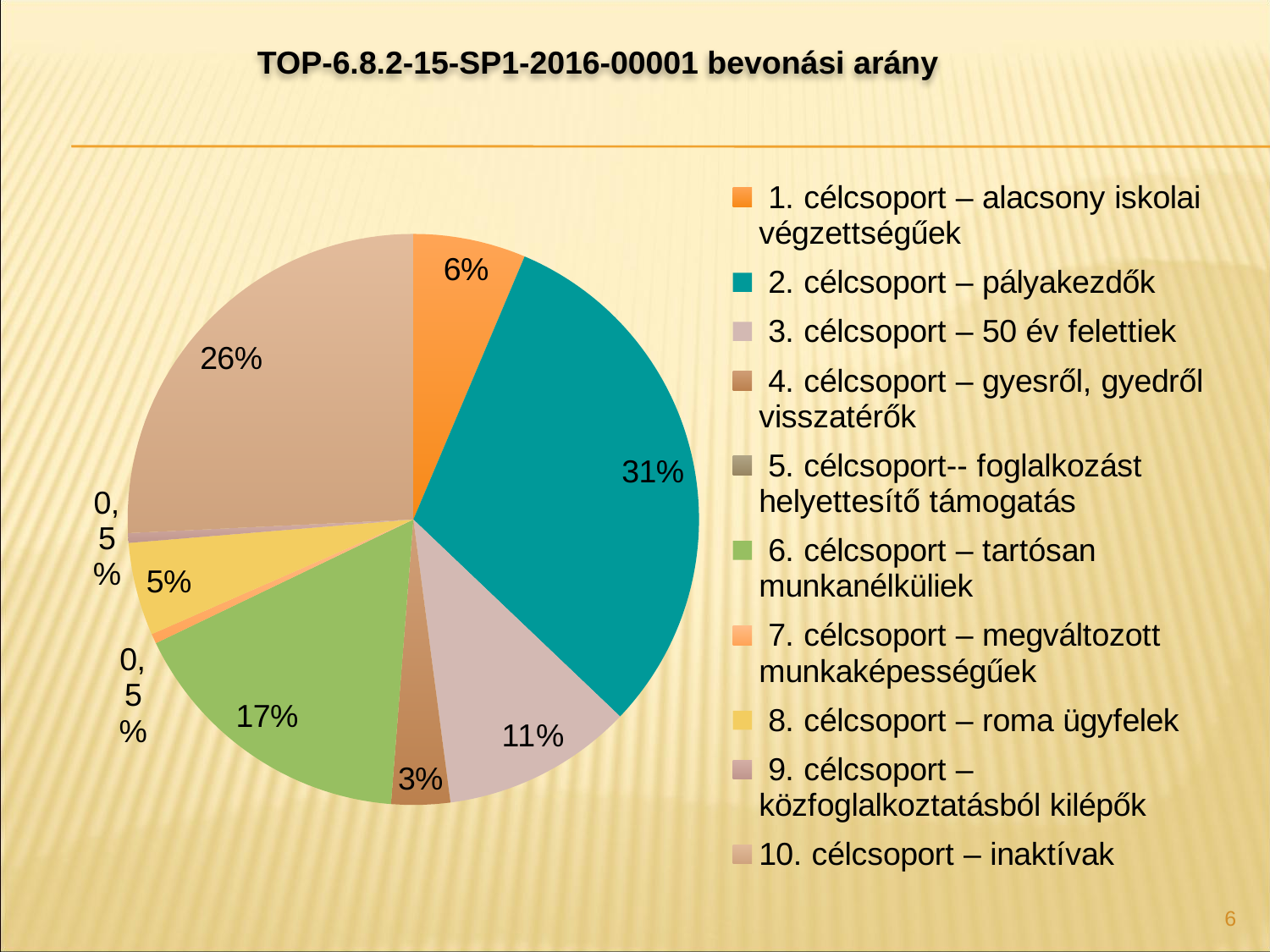
What share of the pie does '8. célcsoport – roma ügyfelek' have? 5% Which category has the largest share of the pie? 2. célcsoport – pályakezdők What share of the pie does '10. célcsoport – inaktívak' have? 26% What is the difference between the share for '2. célcsoport – pályakezdők' and the share for '3. célcsoport – 50 év felettiek'? 20% What share of the pie does '6. célcsoport – tartósan munkanélküliek' have? 17% How many categories does the legend list? 10 What share of the pie does '2. célcsoport – pályakezdők' have? 31% What share of the pie does '4. célcsoport – gyesről, gyedről visszatérők' have? 3% What share of the pie does '3. célcsoport – 50 év felettiek' have? 11% What kind of chart is shown on the slide? pie chart Which is larger, the share for '10. célcsoport – inaktívak' or the share for '6. célcsoport – tartósan munkanélküliek'? 10. célcsoport – inaktívak What share of the pie does '1. célcsoport – alacsony iskolai végzettségűek' have? 6%